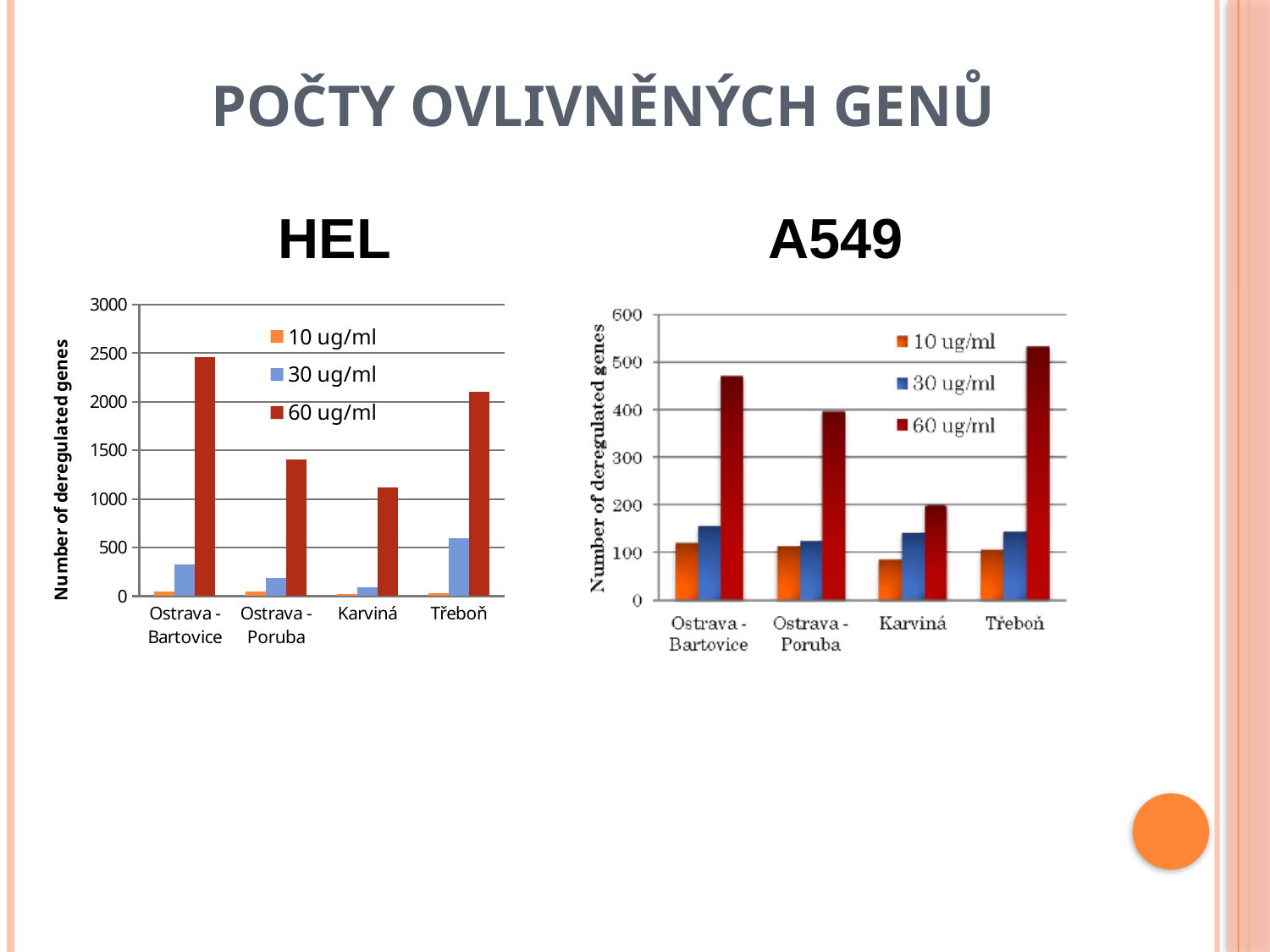
In the HEL chart, is the 30 ug/ml value for Třeboň greater or less than 500? greater In the A549 chart, is the 60 ug/ml value for Třeboň greater or less than 500? greater In the HEL chart, which location has the highest number of deregulated genes at 60 ug/ml? Ostrava - Bartovice In the HEL chart, which is larger at 30 ug/ml: Třeboň or Ostrava - Bartovice? Třeboň In the A549 chart, which is larger at 60 ug/ml: Ostrava - Bartovice or Ostrava - Poruba? Ostrava - Bartovice How many series does the legend of the A549 chart list? 3 In the HEL chart, is the 60 ug/ml value for Karviná greater or less than 1500? less In the HEL chart, which location has the lowest number of deregulated genes at 60 ug/ml? Karviná In the A549 chart, which location has the highest number of deregulated genes at 60 ug/ml? Třeboň What kind of chart is the HEL chart? bar chart In the A549 chart, which location has the lowest number of deregulated genes at 60 ug/ml? Karviná